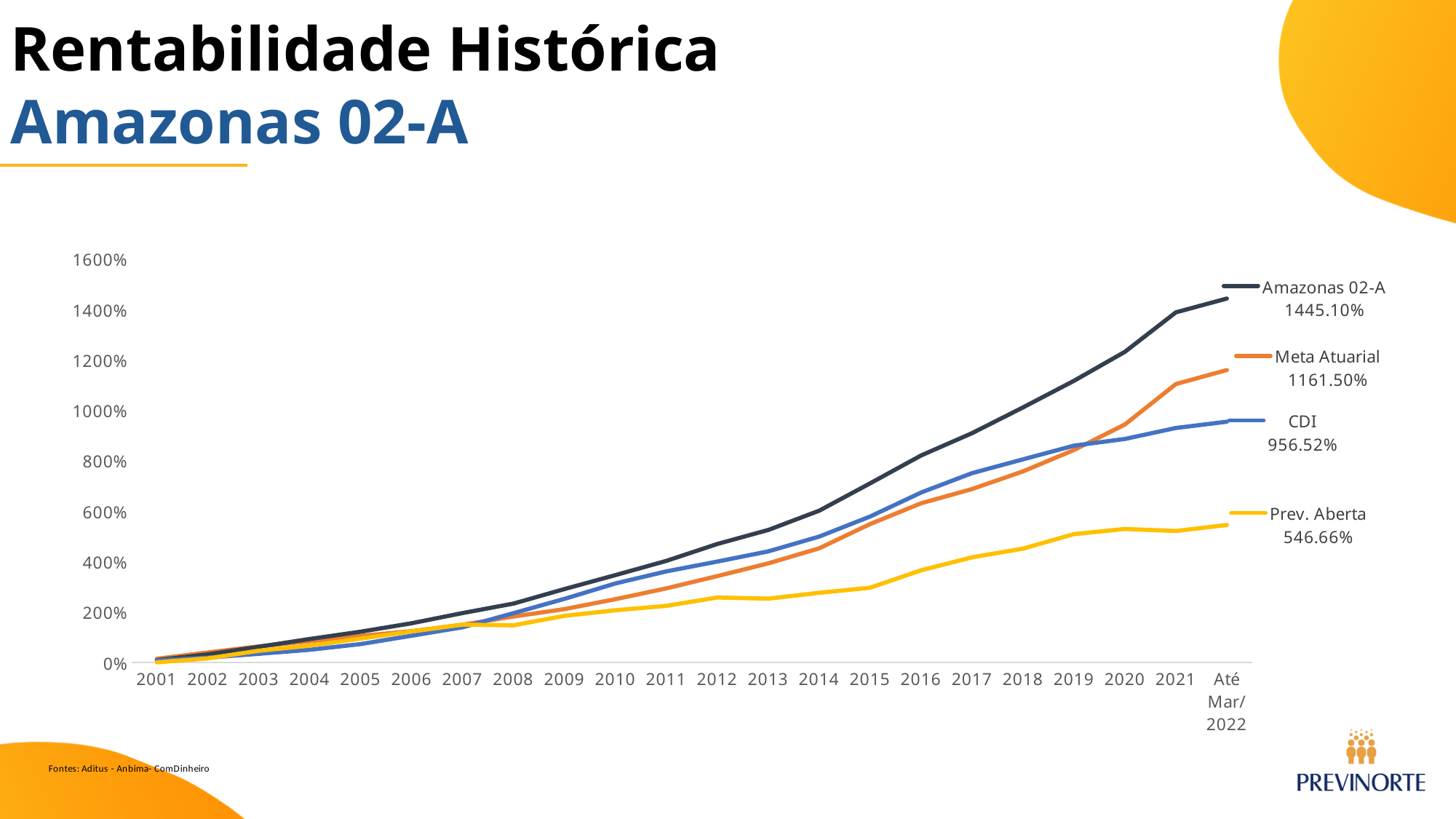
What is the final value shown for Meta Atuarial? 1161.50% What is the final value shown for Prev. Aberta? 546.66% Which series has the highest value at the end of the chart? Amazonas 02-A Is the value for Prev. Aberta in 2021 greater or less than 600%? less How many points are there along the x axis? 22 How many series does the chart show? 4 What is the final value shown for Amazonas 02-A? 1445.10% Which series has the lowest value at the end of the chart? Prev. Aberta What is the difference between the final values of Amazonas 02-A and Meta Atuarial? 283.60% Which has a larger final value, CDI or Meta Atuarial? Meta Atuarial What is the final value shown for CDI? 956.52% What type of chart is shown on the slide? line chart